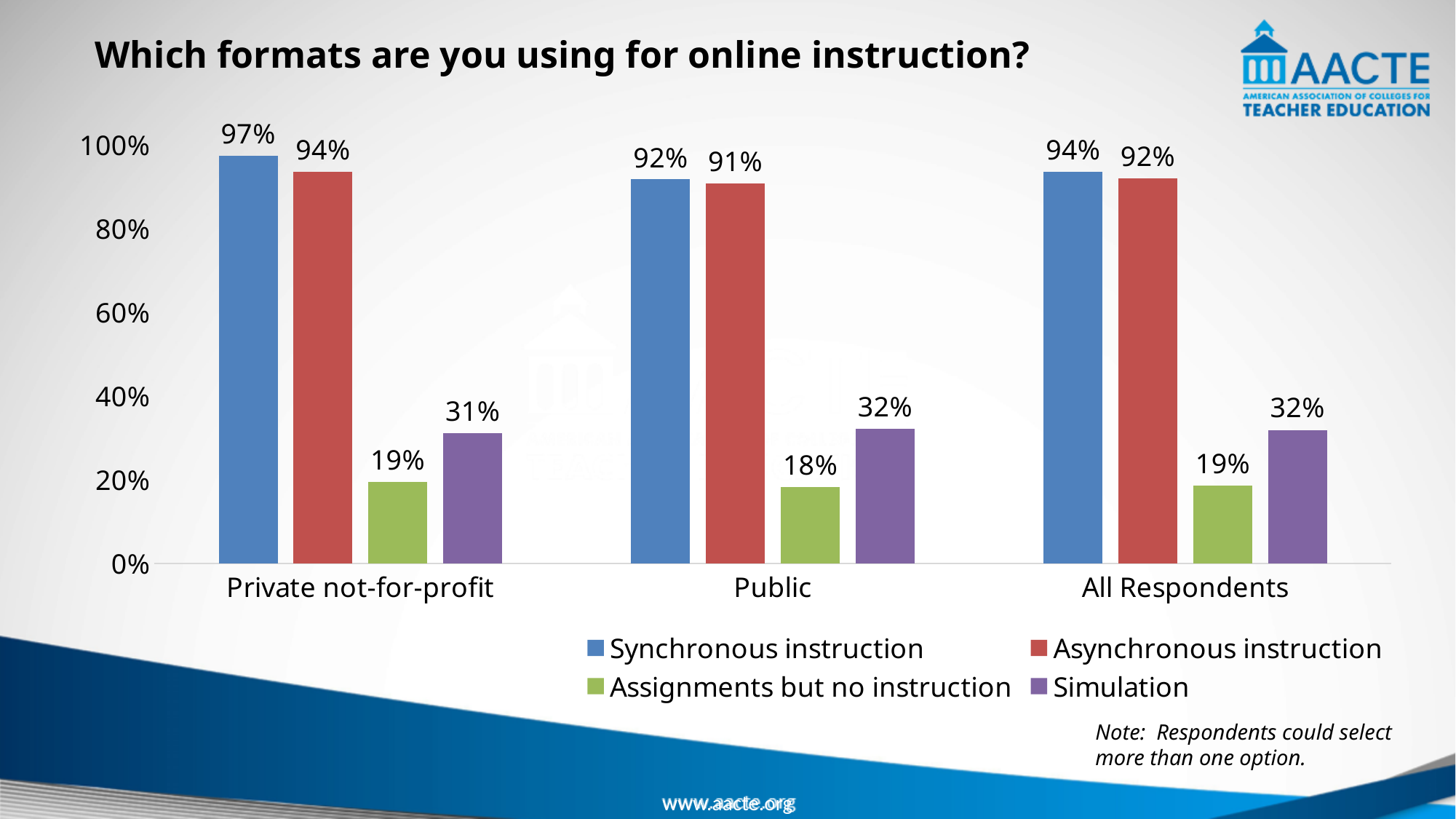
Which format has the lowest value for Public respondents? Assignments but no instruction What is the value for Simulation among Public respondents? 32% Which is larger for Private not-for-profit: Simulation or Assignments but no instruction? Simulation What is the difference between Synchronous instruction and Simulation for All Respondents? 62% How many series does the legend list? 4 What is the value for Asynchronous instruction among Public respondents? 91% What kind of chart is shown on the slide? Bar chart How many respondent groups are shown on the x axis? 3 What percentage of All Respondents use Assignments but no instruction? 19% What colour represents Simulation in the chart? Purple What percentage of Private not-for-profit respondents use Synchronous instruction? 97% Which format has the highest value for Private not-for-profit respondents? Synchronous instruction